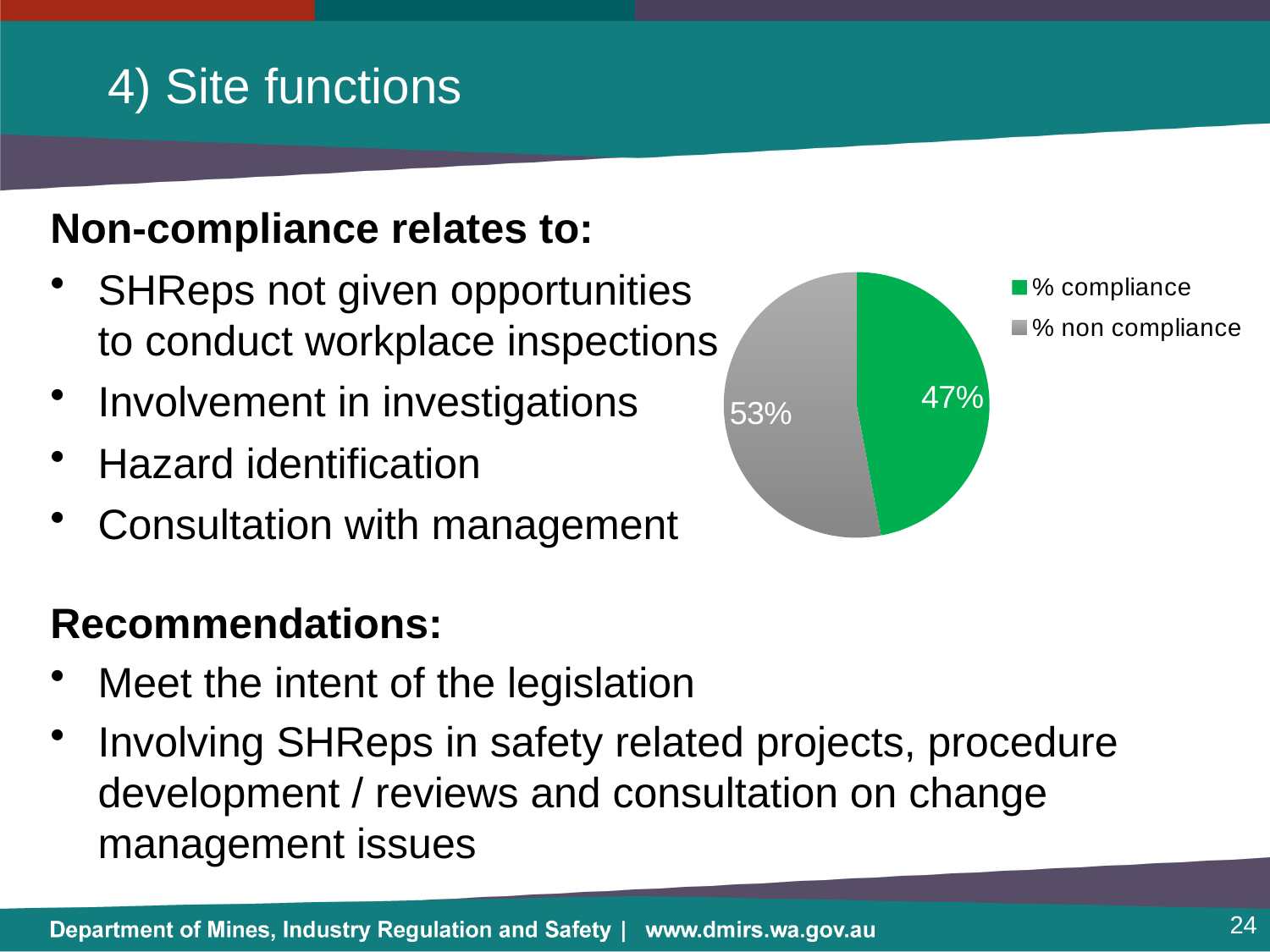
Which slice is the largest? % non compliance What is the value for % non compliance? 53% How many slices does the pie chart have? 2 What type of chart is shown on the slide? pie chart Which slice is the smallest? % compliance What share of the pie does % compliance represent? 47% What colour is the % non compliance slice? grey Which is larger, % compliance or % non compliance? % non compliance What is the value for % compliance? 47% What colour is the % compliance slice? green How many entries does the legend list? 2 What is the difference between % non compliance and % compliance? 6%